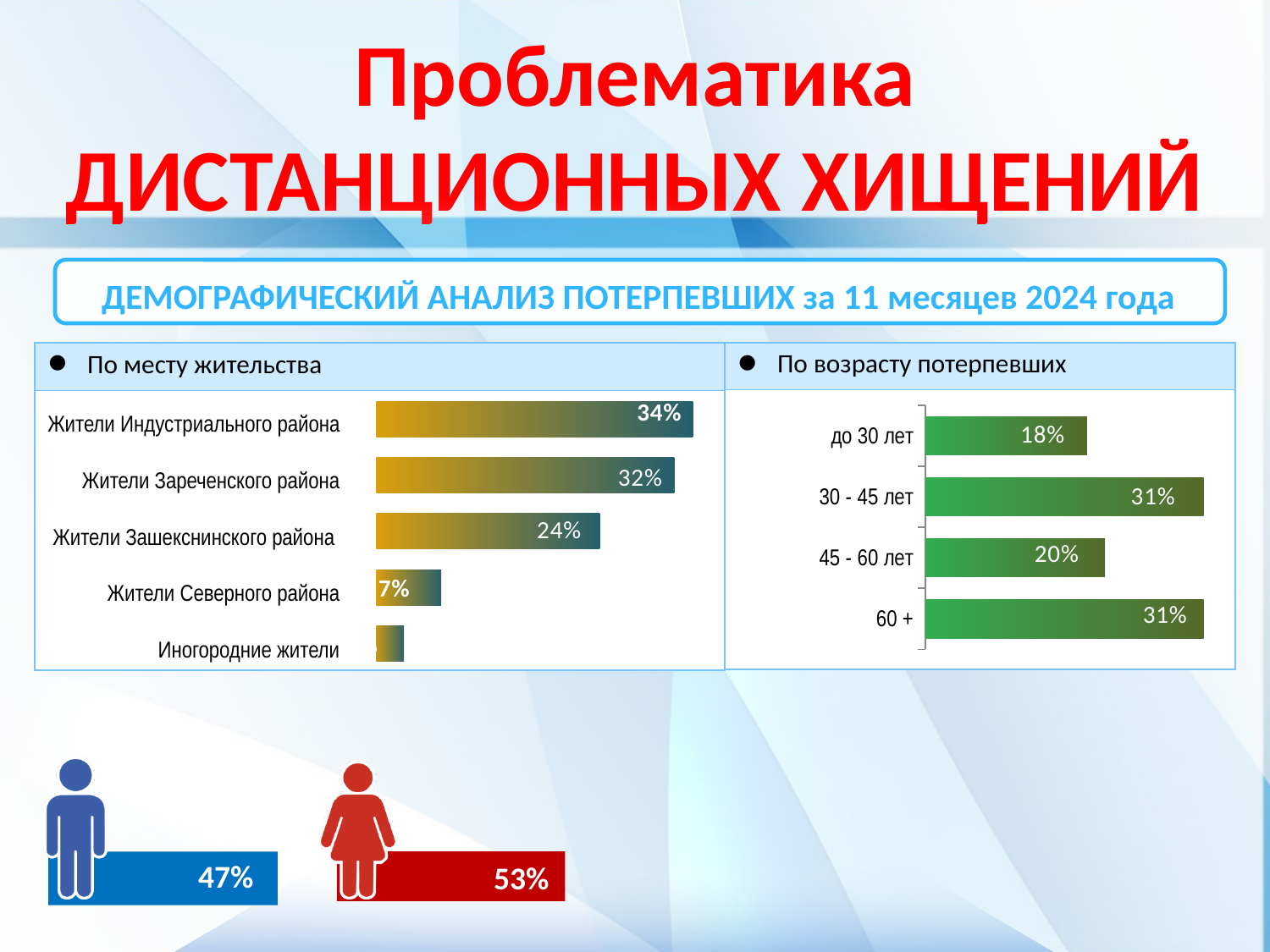
What type of chart is "По возрасту потерпевших"? Bar chart In the chart "По месту жительства", what is the value for Жители Индустриального района? 34% In the chart "По месту жительства", what is the value for Жители Зашекснинского района? 24% In the chart "По месту жительства", how many categories are shown? 5 In the chart "По возрасту потерпевших", what is the value for 45 - 60 лет? 20% In the chart "По возрасту потерпевших", which age group has the lowest value? до 30 лет In the chart "По возрасту потерпевших", which is larger: the value for 30 - 45 лет or the value for 45 - 60 лет? 30 - 45 лет In the chart "По возрасту потерпевших", what is the value for 60 +? 31% In the chart "По месту жительства", which category has the lowest value? Иногородние жители In the chart "По возрасту потерпевших", how many age groups are shown? 4 In the chart "По месту жительства", which category has the highest value? Жители Индустриального района In the chart "По месту жительства", what is the difference between the values for Жители Зареченского района and Жители Северного района? 25%